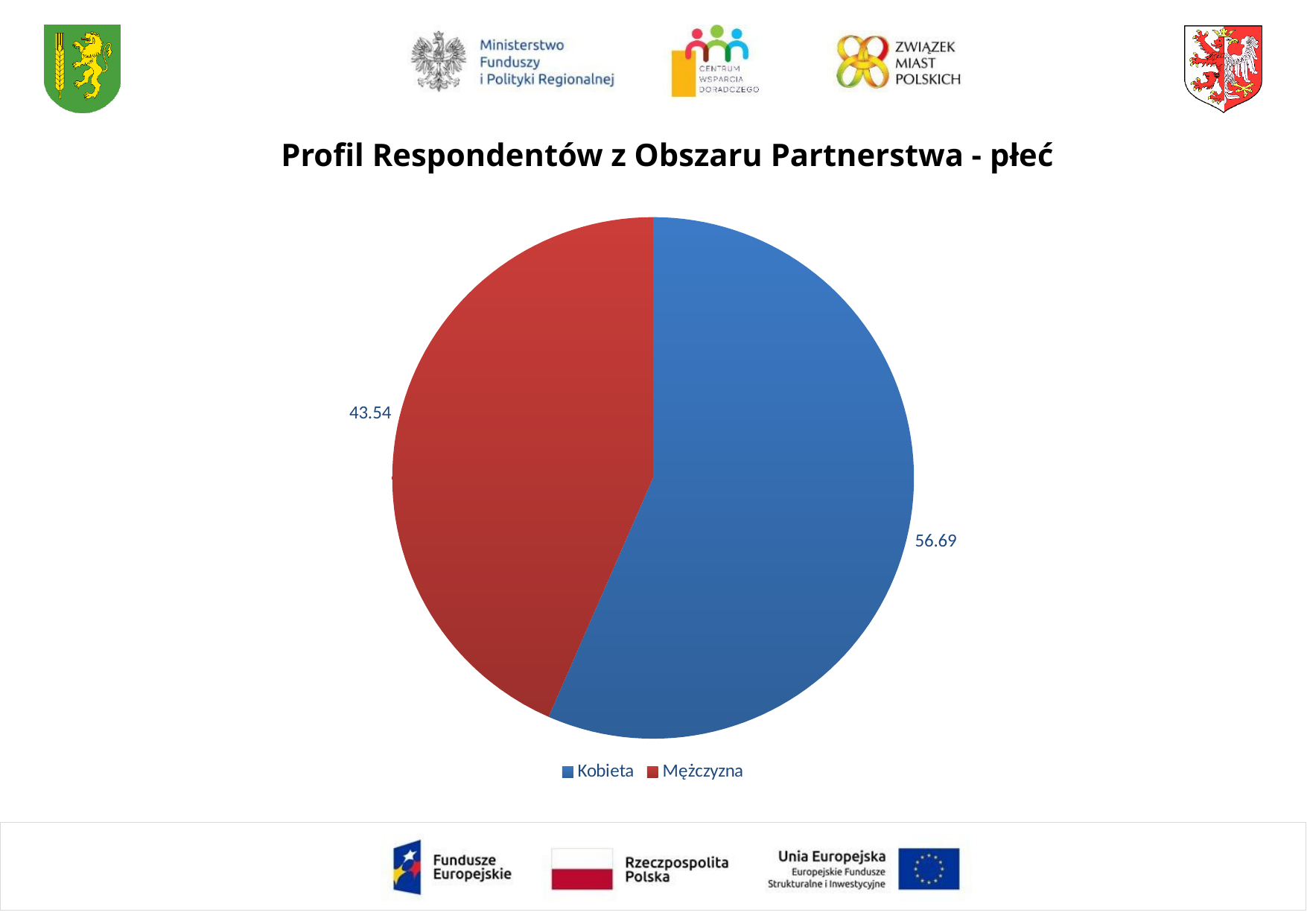
What type of chart is shown on the slide? pie chart What is the difference between the values for Kobieta and Mężczyzna? 13.15 Which is larger, the value for Kobieta or the value for Mężczyzna? Kobieta How many entries does the legend list? 2 What is the value shown for Mężczyzna? 43.54 How many slices does the pie chart have? 2 Which category has the smallest slice of the pie? Mężczyzna What is the value shown for Kobieta? 56.69 What colour is the slice for Mężczyzna? red What share of the pie is labelled for Kobieta? 56.69 Which category has the largest slice of the pie? Kobieta What is the title of the chart? Profil Respondentów z Obszaru Partnerstwa - płeć